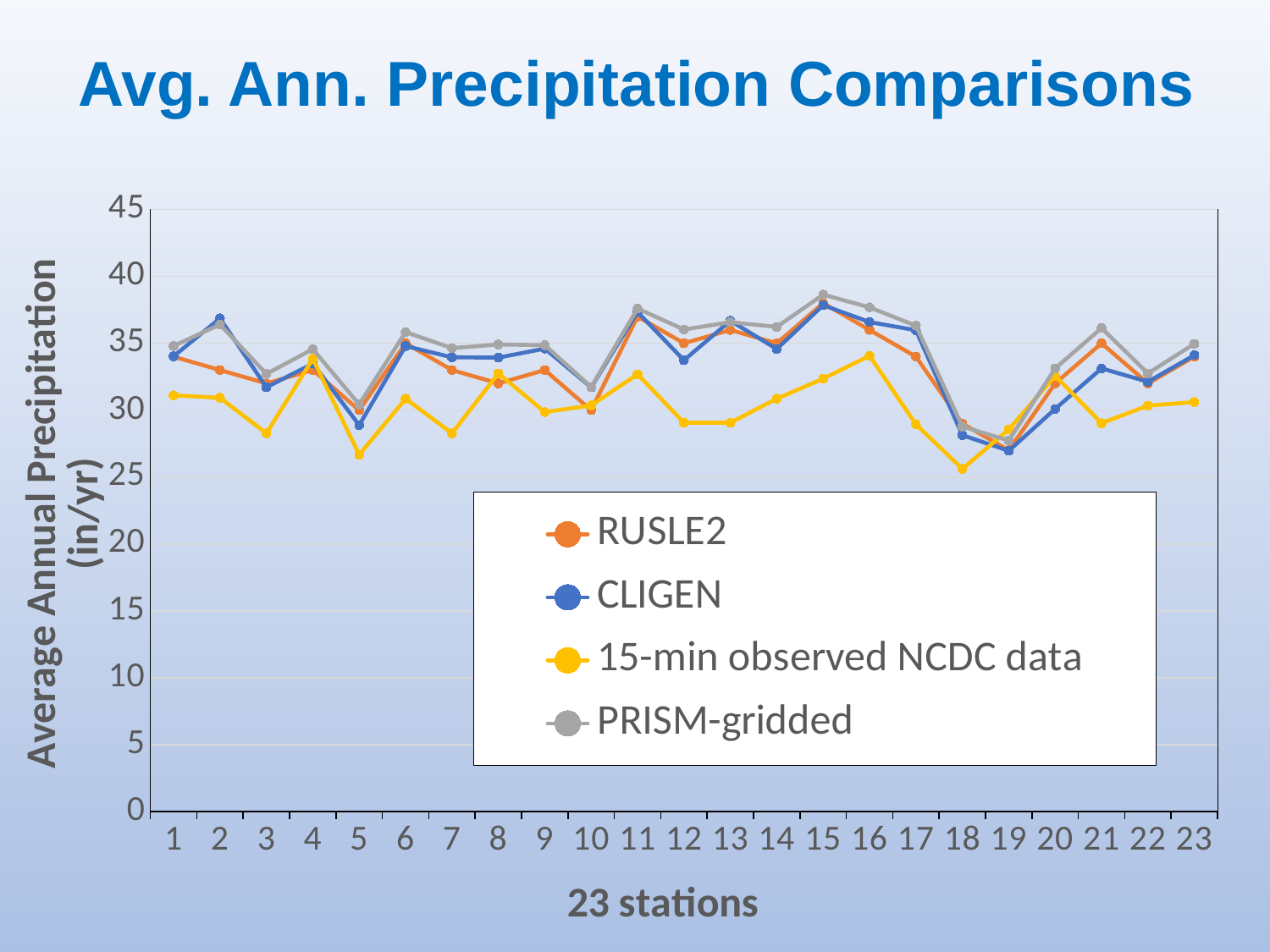
At which station is the 15-min observed NCDC data value lowest? 18 At station 1, which is higher, PRISM-gridded or 15-min observed NCDC data? PRISM-gridded Do the RUSLE2 values rise or fall from station 17 to station 18? fall How many series does the legend list? 4 Is the value for RUSLE2 at station 11 greater or less than 35? greater Is the value for PRISM-gridded at station 15 greater or less than 35? greater What kind of chart is shown on the slide? line chart What is the title of the chart? Avg. Ann. Precipitation Comparisons Is the value for 15-min observed NCDC data at station 18 greater or less than 30? less What is the label of the y axis? Average Annual Precipitation (in/yr) How many stations are plotted along the x axis? 23